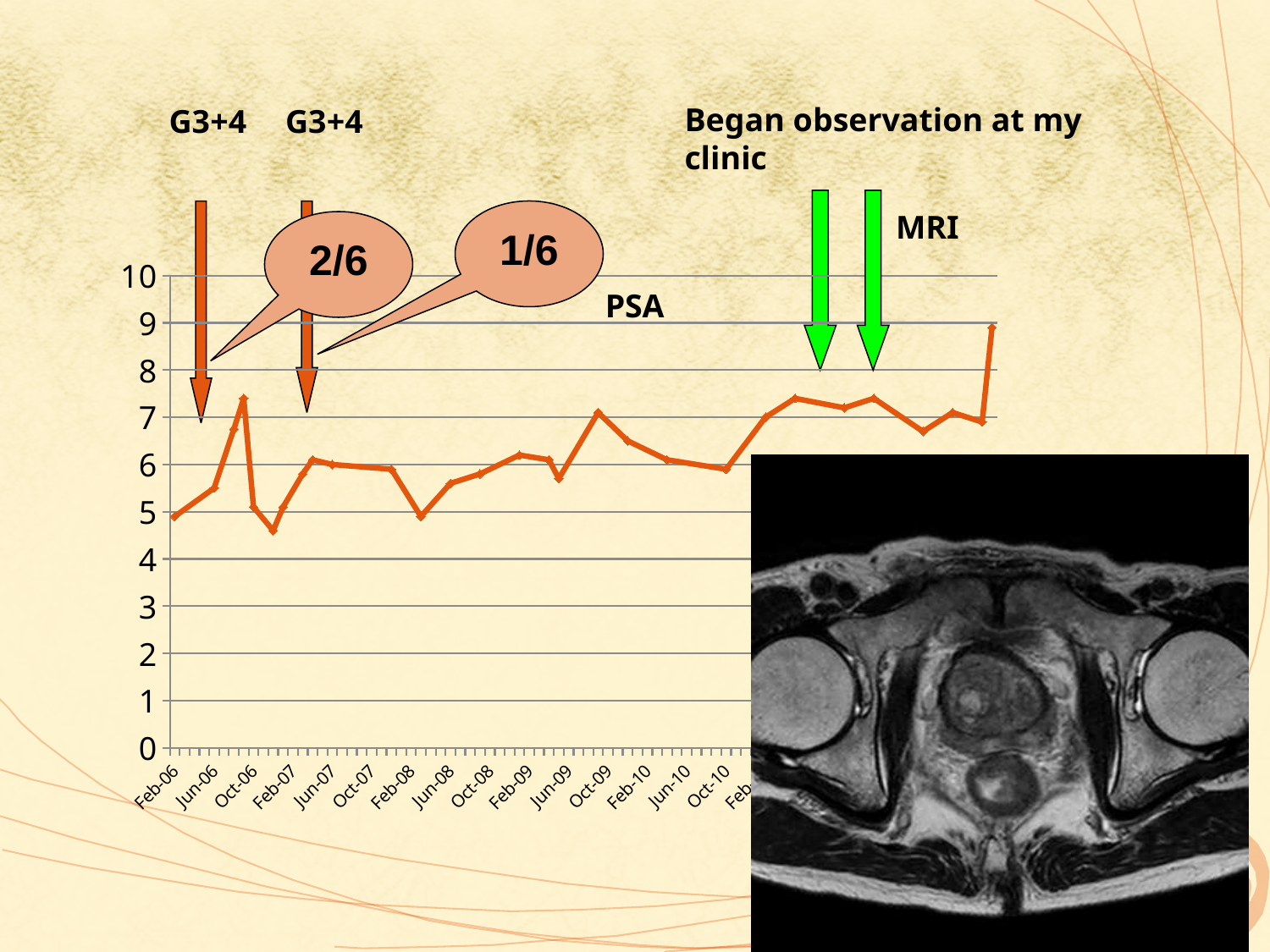
Is the last plotted PSA value on the chart greater or less than 8? greater Is the PSA value for Oct-09 greater or less than 6? greater Overall, does the PSA value rise or fall from the first point to the last point on the chart? rise What is the highest value shown on the y axis of the chart? 10 Is the PSA value for Feb-06 greater or less than 6? less Which has the larger PSA value, Feb-06 or Oct-09? Oct-09 What is the label of the plotted series on the chart? PSA What kind of chart is shown on the slide? line chart What is the first date label on the x axis of the chart? Feb-06